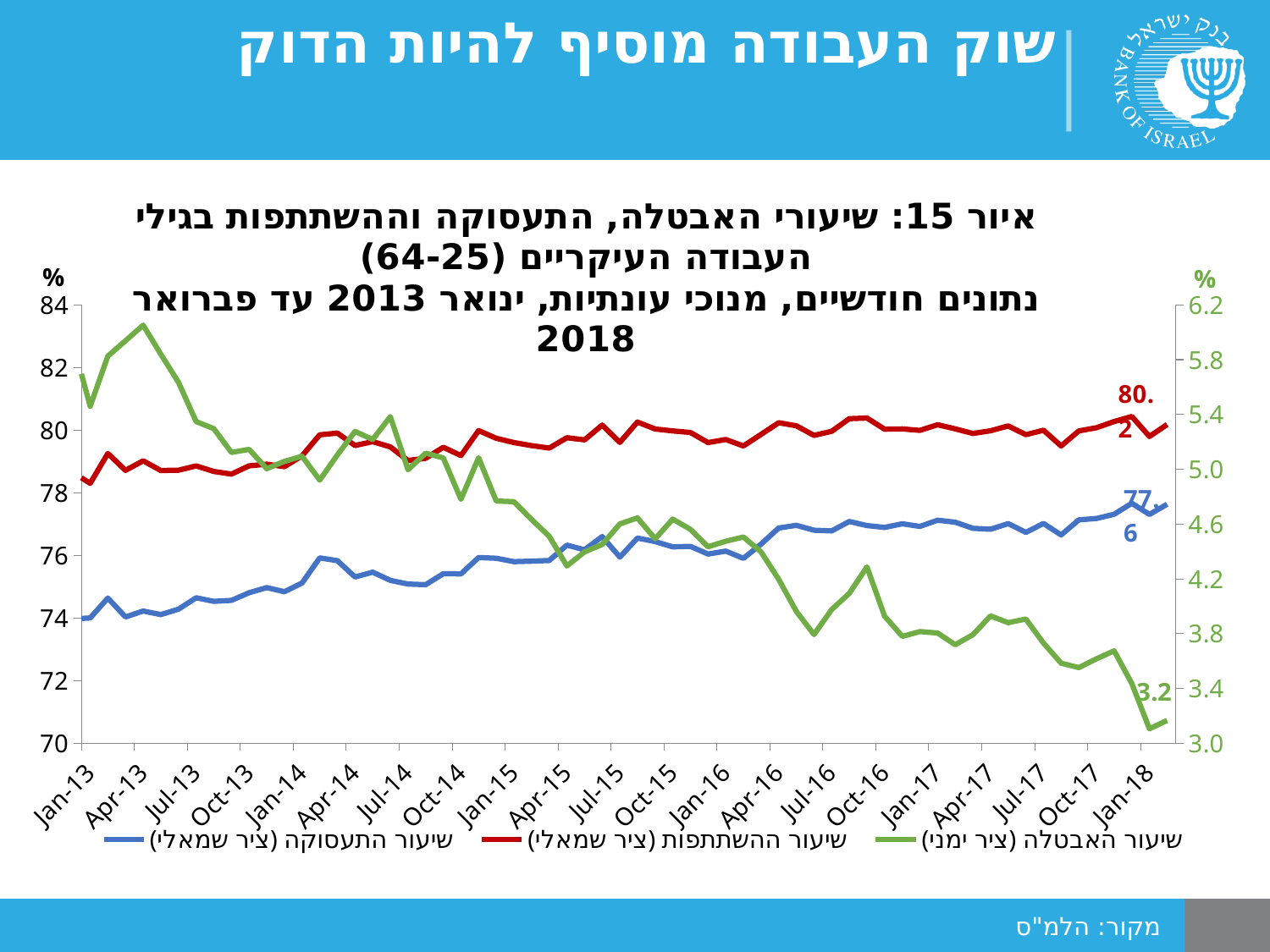
What is the last labelled value of the green line (שיעור האבטלה)? 3.2 What kind of chart is shown on the slide? line chart Does the green line (שיעור האבטלה) generally rise or fall from Jan-13 to Jan-18? fall What is the difference between the final labelled values of שיעור ההשתתפות (80.2) and שיעור התעסוקה (77.6)? 2.6 Is the value of the green line (שיעור האבטלה) at Apr-13 greater or less than 5.8 on the right axis? greater At the end of the period, which is higher: שיעור ההשתתפות or שיעור התעסוקה? שיעור ההשתתפות Is the value of the blue line (שיעור התעסוקה) at Jan-13 greater or less than 76? less What is the last labelled value of the blue line (שיעור התעסוקה)? 77.6 Does the blue line (שיעור התעסוקה) generally rise or fall from Jan-13 to Jan-18? rise How many series does the legend list? 3 What is the last labelled value of the red line (שיעור ההשתתפות)? 80.2 According to the legend, which axis does שיעור האבטלה use? ציר ימני